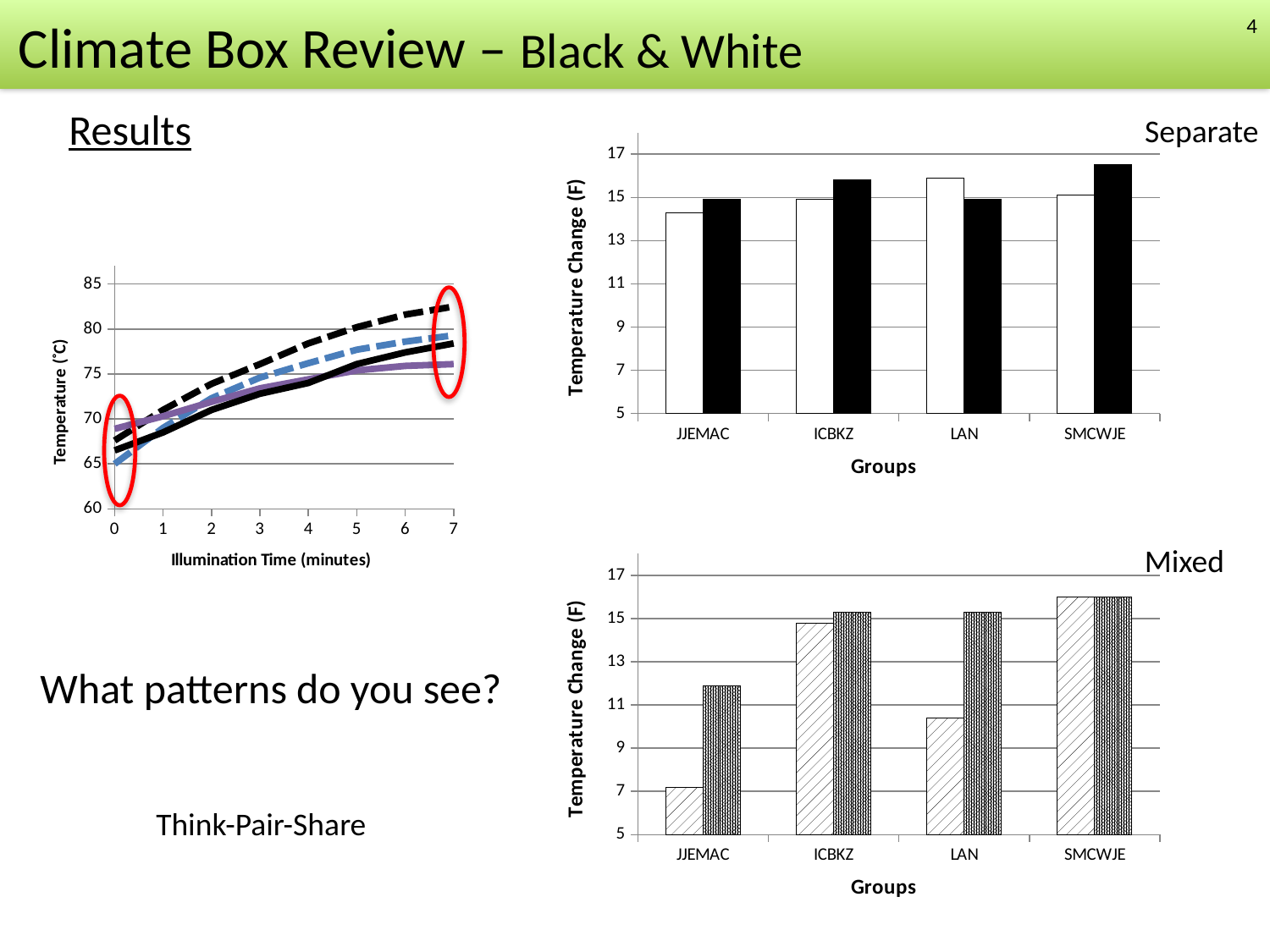
In the "Mixed" chart, is the value of the left (hatched) bar for JJEMAC greater or less than 9? less In the "Mixed" chart, how many bars are shown for each group? 2 What kind of chart is the chart titled "Separate"? bar chart In the "Separate" chart, how many groups are shown on the x axis? 4 In the "Separate" chart, is the value of the white bar for JJEMAC greater or less than 15? less What kind of chart is the chart in the lower left of the slide with Illumination Time on the x axis? line chart In the "Mixed" chart, is the value of the left (hatched) bar for LAN greater or less than 11? less What is the y-axis label of the "Mixed" chart? Temperature Change (F) In the line chart, do the temperatures generally rise or fall as illumination time increases? rise In the "Separate" chart, which is larger for LAN: the white bar or the black bar? the white bar In the "Mixed" chart, which group has the lowest bar? JJEMAC